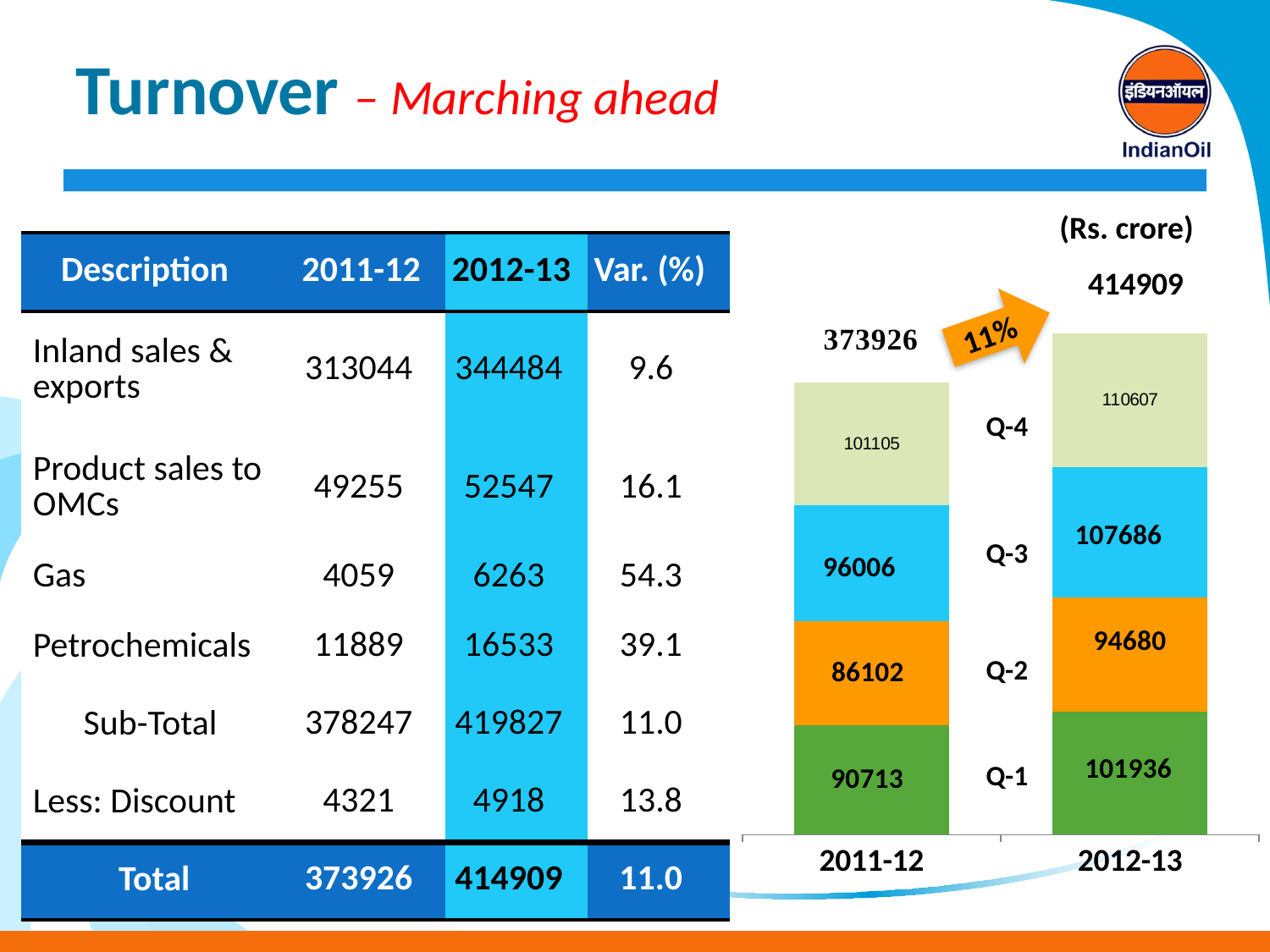
Which is larger, the Q-3 value for 2011-12 or the Q-3 value for 2012-13? 2012-13 What is the Q-3 value for 2011-12 in the chart? 96006 How many bars (years) are shown on the x axis of the chart? 2 What is the total turnover shown above the 2011-12 bar? 373926 Which quarter has the highest value in the 2012-13 bar? Q-4 What is the difference between the Q-2 values for 2012-13 and 2011-12? 8578 What is the Q-1 value for 2012-13 in the chart? 101936 What type of chart is shown on the slide? Stacked bar chart Which quarter has the lowest value in the 2011-12 bar? Q-2 What is the Q-4 value for 2012-13 in the chart? 110607 What is the total turnover shown above the 2012-13 bar? 414909 What percentage growth is shown on the arrow between the two bars? 11%